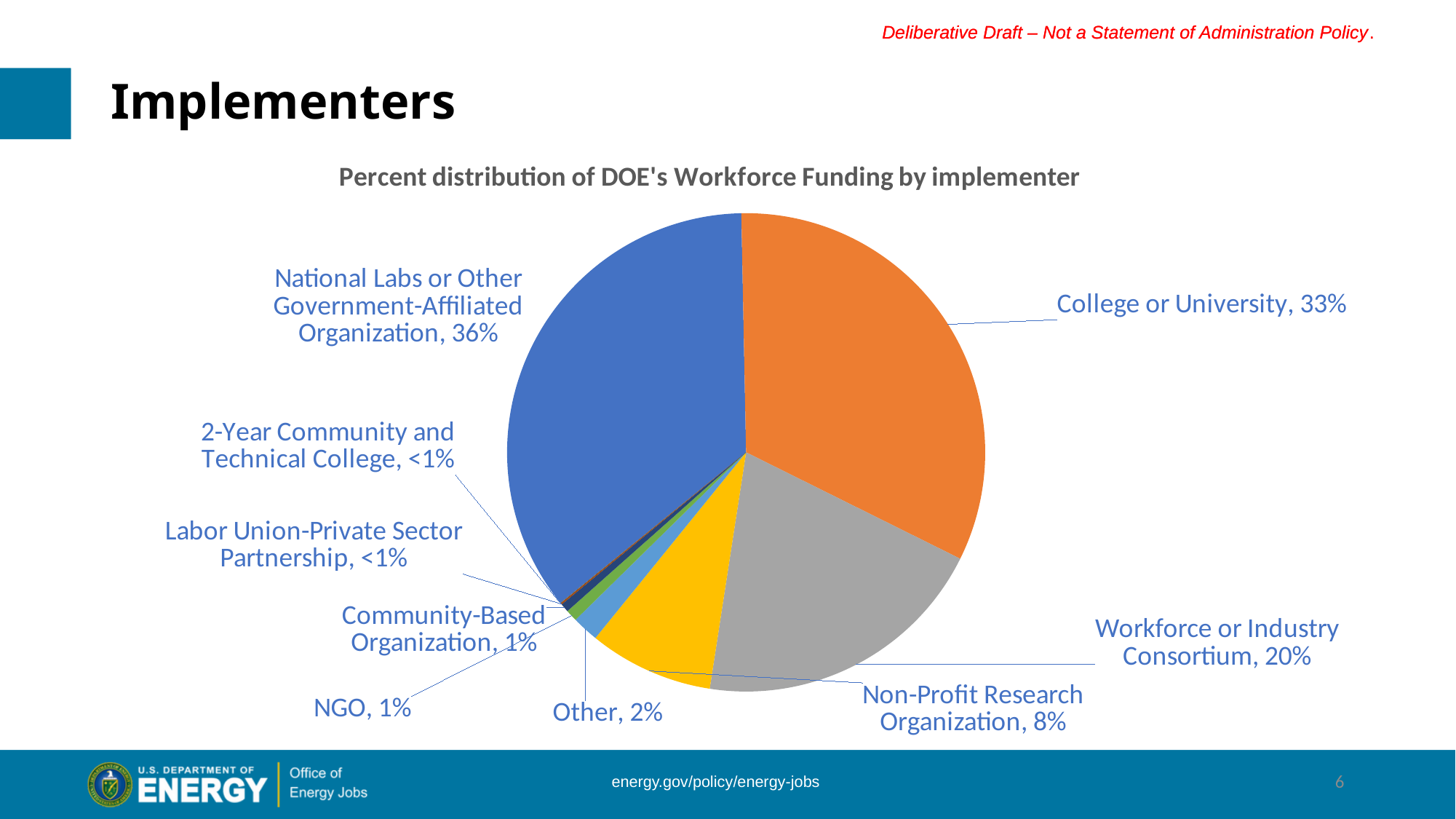
What share is shown for Workforce or Industry Consortium? 20% How many percentage points larger is the National Labs or Other Government-Affiliated Organization share than the College or University share? 3 What share is labelled for the Other category? 2% How many implementer categories are shown in the pie chart? 9 What type of chart is shown on the slide? Pie chart What percentage is shown for Non-Profit Research Organization? 8% Which implementer category has the largest share of the pie? National Labs or Other Government-Affiliated Organization What share of DOE's Workforce Funding goes to College or University implementers? 33% Which is larger: the share for Workforce or Industry Consortium or the share for Non-Profit Research Organization? Workforce or Industry Consortium What percentage is shown for Labor Union-Private Sector Partnership? <1% What percentage of the pie is labelled National Labs or Other Government-Affiliated Organization? 36% What is the title of the chart? Percent distribution of DOE's Workforce Funding by implementer